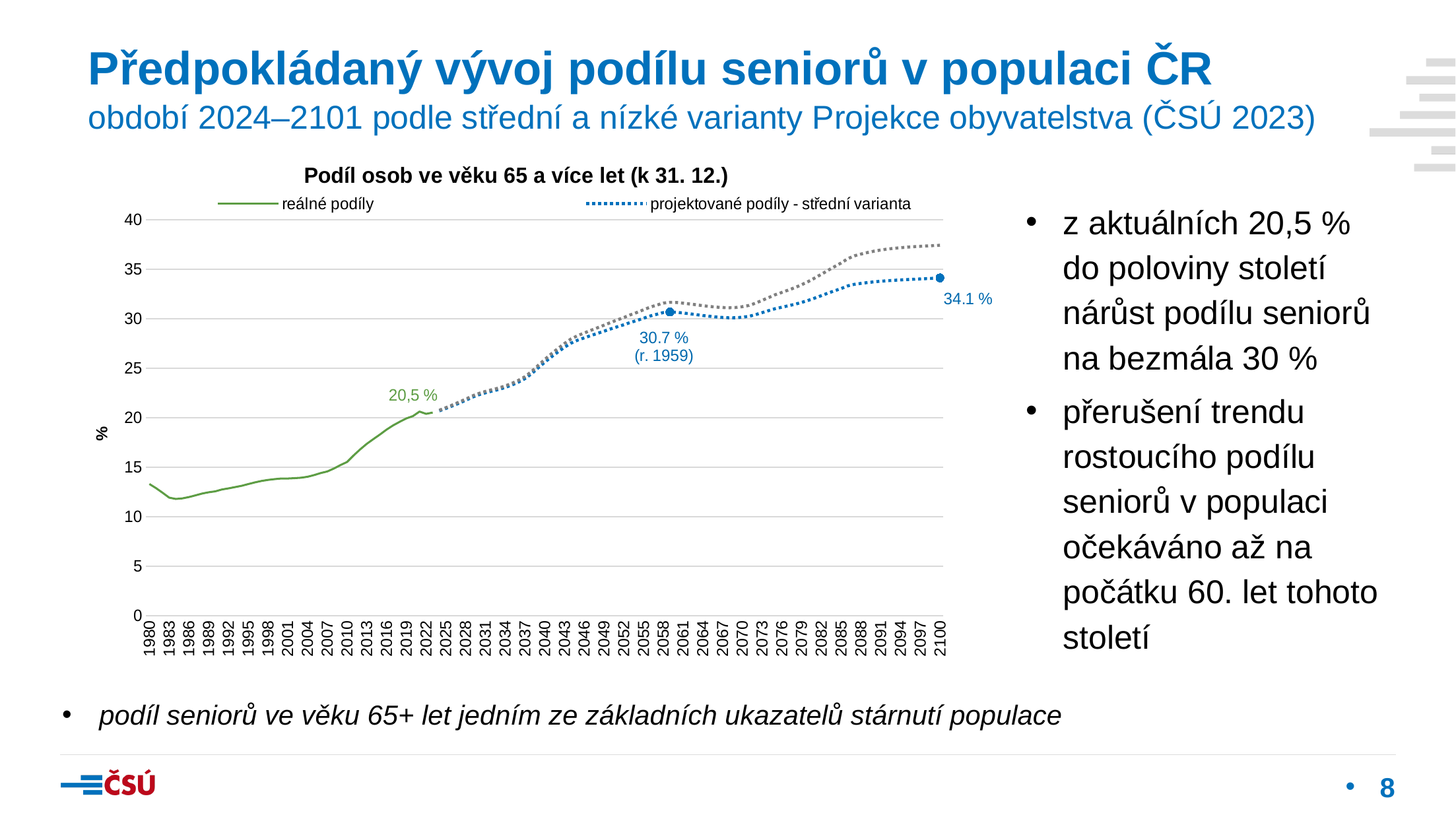
What is the title of the chart? Podíl osob ve věku 65 a více let (k 31. 12.) What value is labelled at the end of the 'reálné podíly' series? 20,5 % What value is labelled on the projected series around 2058? 30.7 % Is the projected value (střední varianta) for 2085 greater or less than 30? greater How many series does the chart legend list? 2 Is the value for 2010 greater or less than 20? less Is the value for 1980 greater or less than 15? less What kind of chart is shown on the slide? line chart Which is larger: the labelled projected value in 2100 or the labelled projected value around 2058? 2100 Does the 'reálné podíly' series rise or fall between 1986 and 2022? rise What is the difference between the labelled value in 2100 (34.1 %) and the labelled value around 2058 (30.7 %)? 3.4 % What value is labelled at the end of the projected series (střední varianta) in 2100? 34.1 %